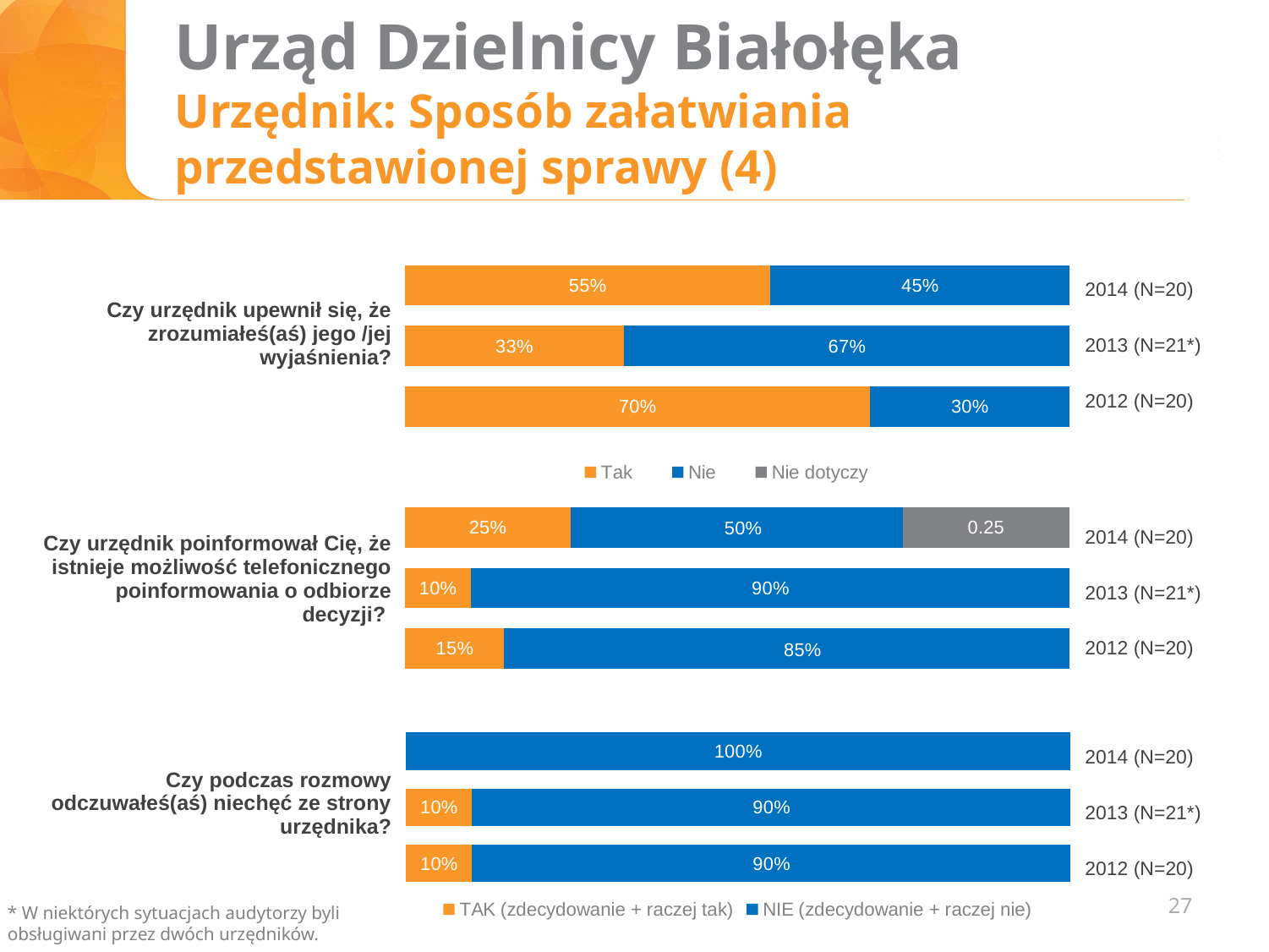
In the chart for "Czy urzędnik poinformował Cię, że istnieje możliwość telefonicznego poinformowania o odbiorze decyzji?", how many series does the legend list? 3 In the chart for "Czy urzędnik poinformował Cię, że istnieje możliwość telefonicznego poinformowania o odbiorze decyzji?", what is the "Nie dotyczy" value shown for 2014 (N=20)? 0.25 In the chart for "Czy podczas rozmowy odczuwałeś(aś) niechęć ze strony urzędnika?", is the "TAK" value for 2013 larger or smaller than the "NIE" value for 2013? smaller In the chart for "Czy urzędnik upewnił się, że zrozumiałeś(aś) jego /jej wyjaśnienia?", what is the "Nie" value for 2013 (N=21*)? 67% In the chart for "Czy urzędnik upewnił się, że zrozumiałeś(aś) jego /jej wyjaśnienia?", what is the "Tak" value for 2014 (N=20)? 55% In the chart for "Czy urzędnik poinformował Cię, że istnieje możliwość telefonicznego poinformowania o odbiorze decyzji?", what is the "Nie" value for 2013 (N=21*)? 90% What kind of chart is used on this slide? Stacked bar chart How many years (bars) are shown in the chart for "Czy podczas rozmowy odczuwałeś(aś) niechęć ze strony urzędnika?"? 3 In the chart for "Czy urzędnik upewnił się, że zrozumiałeś(aś) jego /jej wyjaśnienia?", what is the difference between the "Tak" values for 2012 and 2013? 37 percentage points In the chart for "Czy podczas rozmowy odczuwałeś(aś) niechęć ze strony urzędnika?", what is the "NIE" value for 2014 (N=20)? 100% In the chart for "Czy urzędnik poinformował Cię, że istnieje możliwość telefonicznego poinformowania o odbiorze decyzji?", which year has the lowest "Tak" value? 2013 (N=21*) In the chart for "Czy urzędnik upewnił się, że zrozumiałeś(aś) jego /jej wyjaśnienia?", which year has the highest "Tak" value? 2012 (N=20)